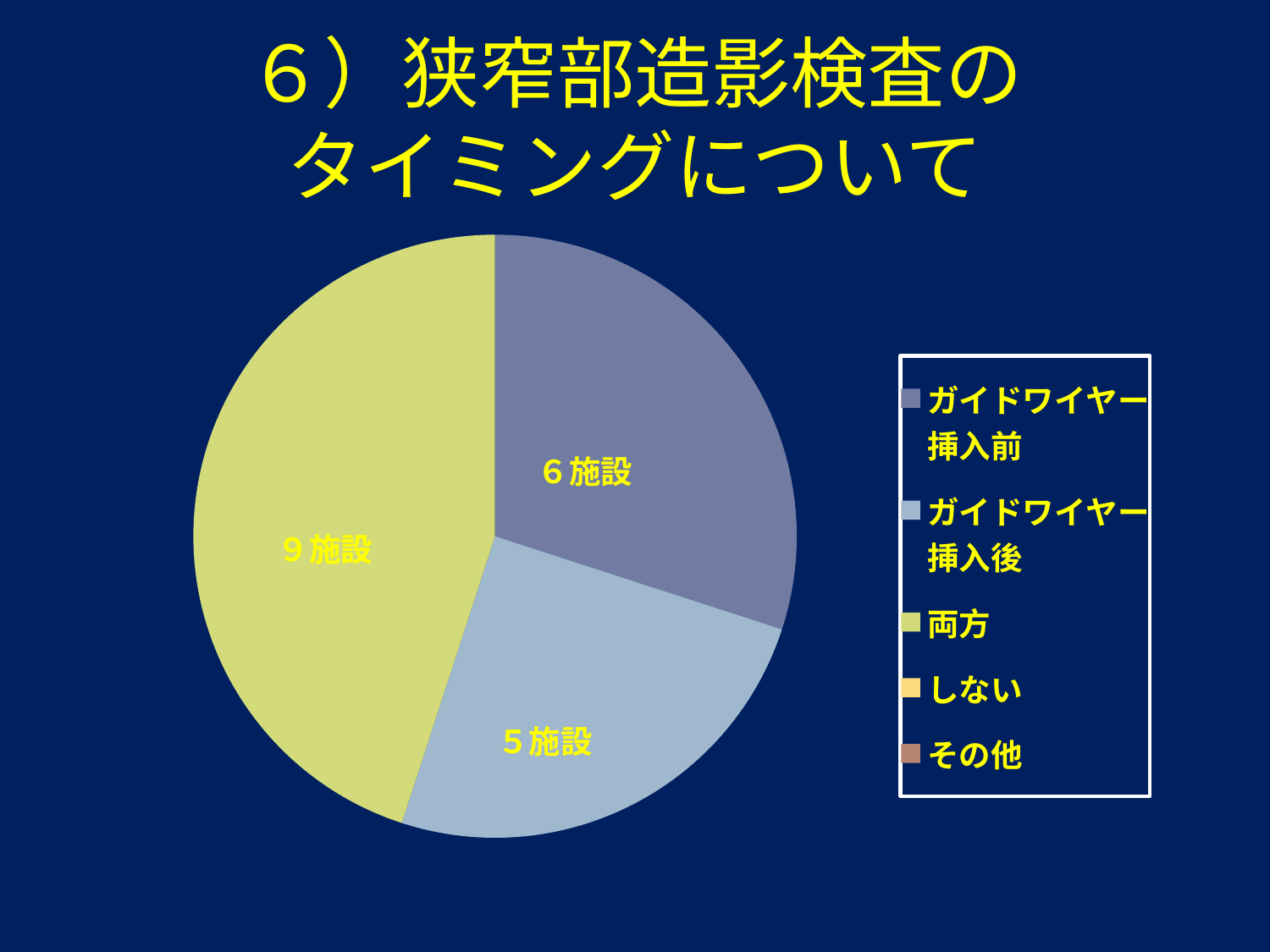
How many entries does the legend list? 5 Which of the labelled slices is the smallest? ガイドワイヤー挿入後 Which category has the largest slice of the pie? 両方 What type of chart is shown on the slide? pie chart How many slices with data labels are visible in the pie chart? 3 What is the difference in the number of facilities between 両方 and ガイドワイヤー挿入前? 3施設 How many facilities are in the 両方 slice? 9施設 What is the title of the slide? 6）狭窄部造影検査のタイミングについて Which has more facilities, ガイドワイヤー挿入前 or ガイドワイヤー挿入後? ガイドワイヤー挿入前 How many facilities are in the ガイドワイヤー挿入前 slice? 6施設 How many facilities are in the ガイドワイヤー挿入後 slice? 5施設 What colour is the 両方 slice in the pie chart? yellow-green